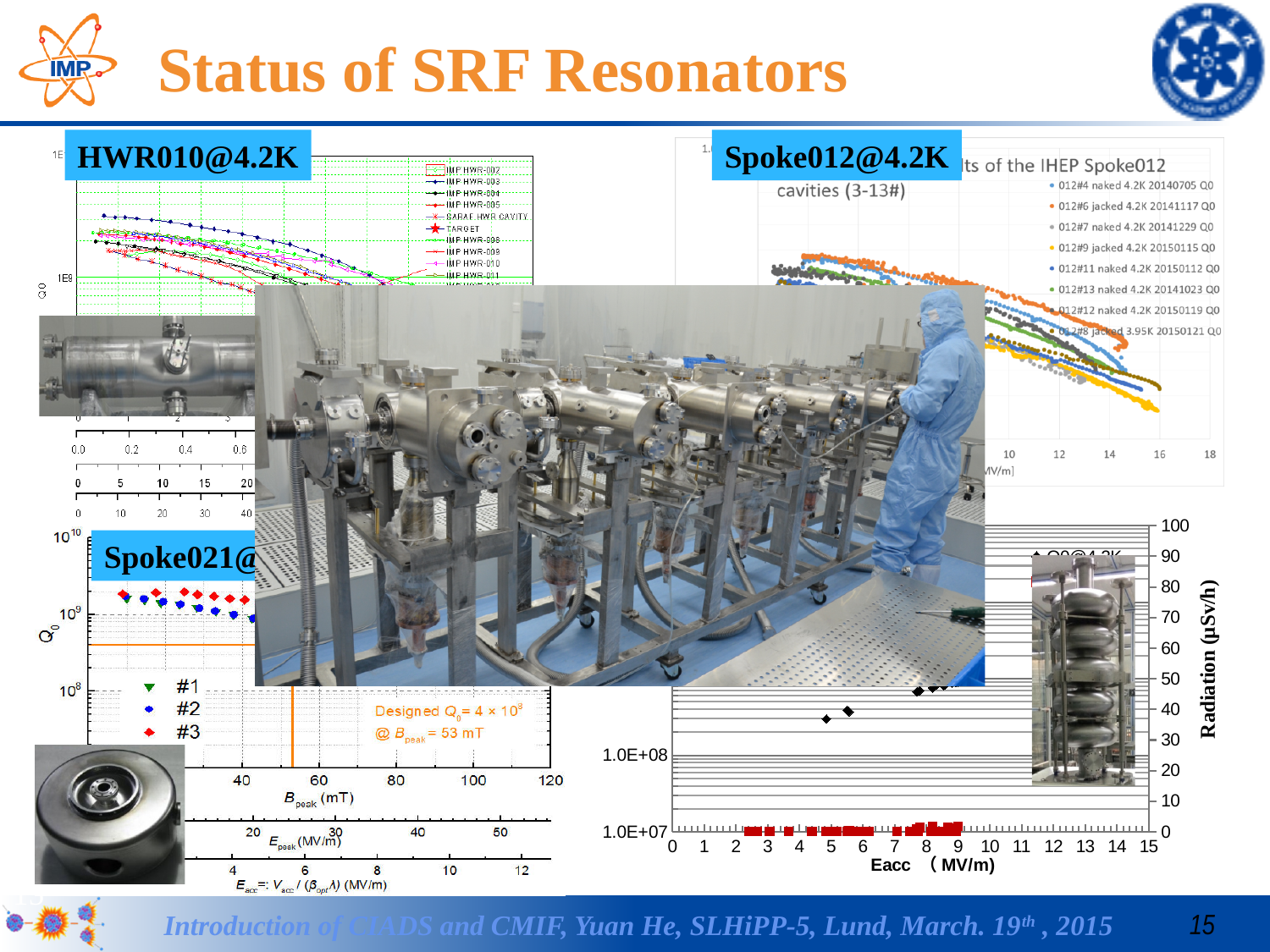
On the bottom-right chart, what is the highest tick value on the Radiation axis? 100 On the Spoke012@4.2K chart, which legend series was measured at 3.95K rather than 4.2K? 012#8 jacked 3.95K 20150121 Q0 On the Spoke021 chart (bottom left), how many series does the legend list? 3 On the bottom-right chart, what is the highest tick value on the Eacc (MV/m) axis? 15 On the Spoke012@4.2K chart, how many series does the legend list? 8 On the bottom-right chart, is the radiation value at Eacc = 5 MV/m greater or less than 10 μSv/h? less On the bottom-right chart, is the Q0 value at Eacc = 5 MV/m greater or less than 1.0E+08? greater On the Spoke021 chart (bottom left), what is the designed Q0 value stated on the chart? 4 × 10^8 What kind of chart is the bottom-right chart of Q0 and radiation versus Eacc? scatter chart On the bottom-right chart, what is the label of the right-hand vertical axis? Radiation (μSv/h) On the HWR010@4.2K chart, how many entries does the legend list? 10 On the Spoke021 chart (bottom left), at what B_peak is the designed Q0 specified? 53 mT